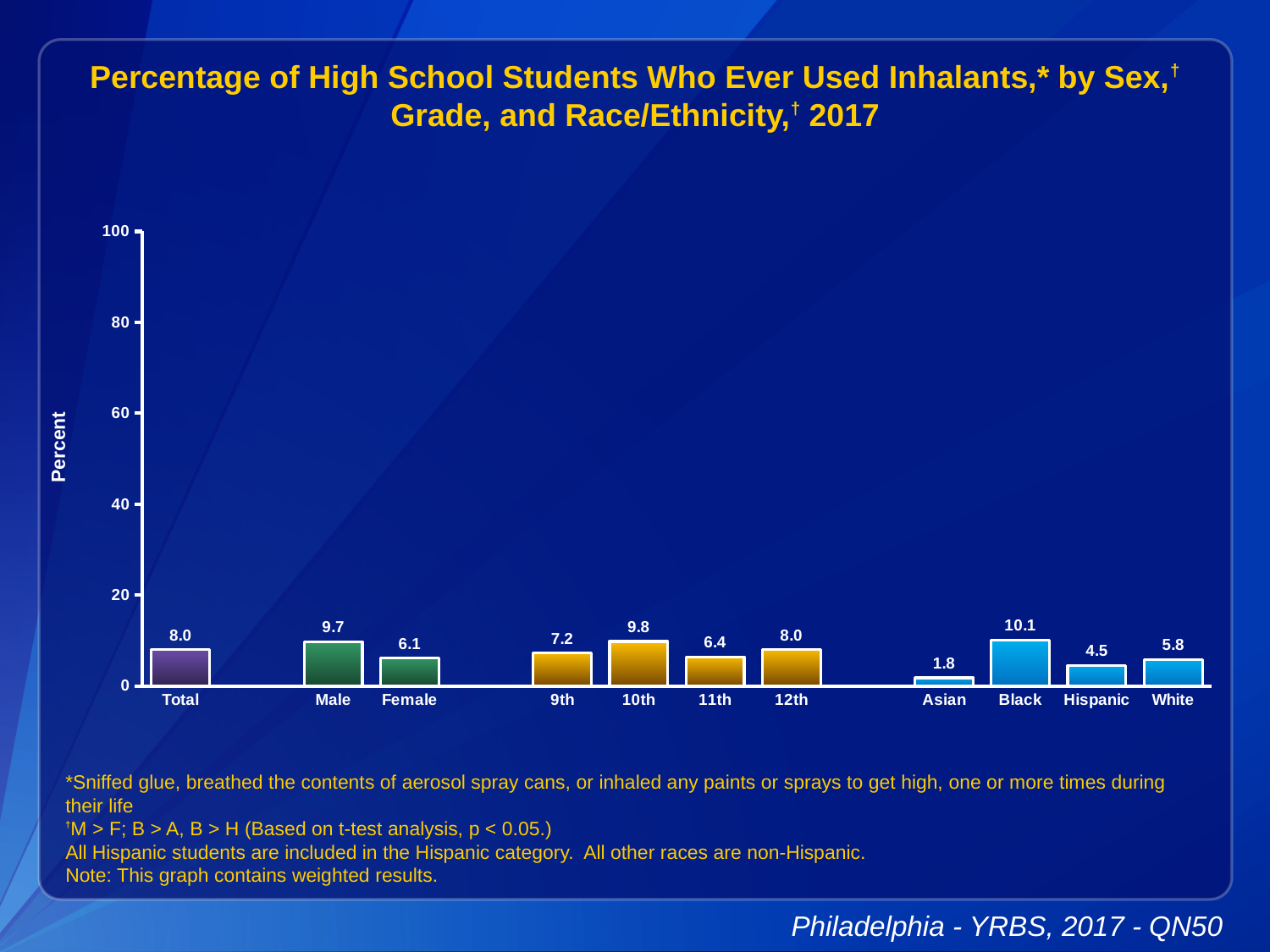
How many categories are shown on the x axis? 11 What is the difference between the Black and Hispanic values? 5.6 Which category has the highest value? Black What is the value for Total? 8.0 What is the value for Asian? 1.8 Which category has the lowest value? Asian What kind of chart is this? bar chart Which is larger, the value for 10th or the value for 11th? 10th What is the difference between the Male and Female values? 3.6 Is the value for Black greater or less than 20? less What is the label of the y axis? Percent What is the value for Male? 9.7